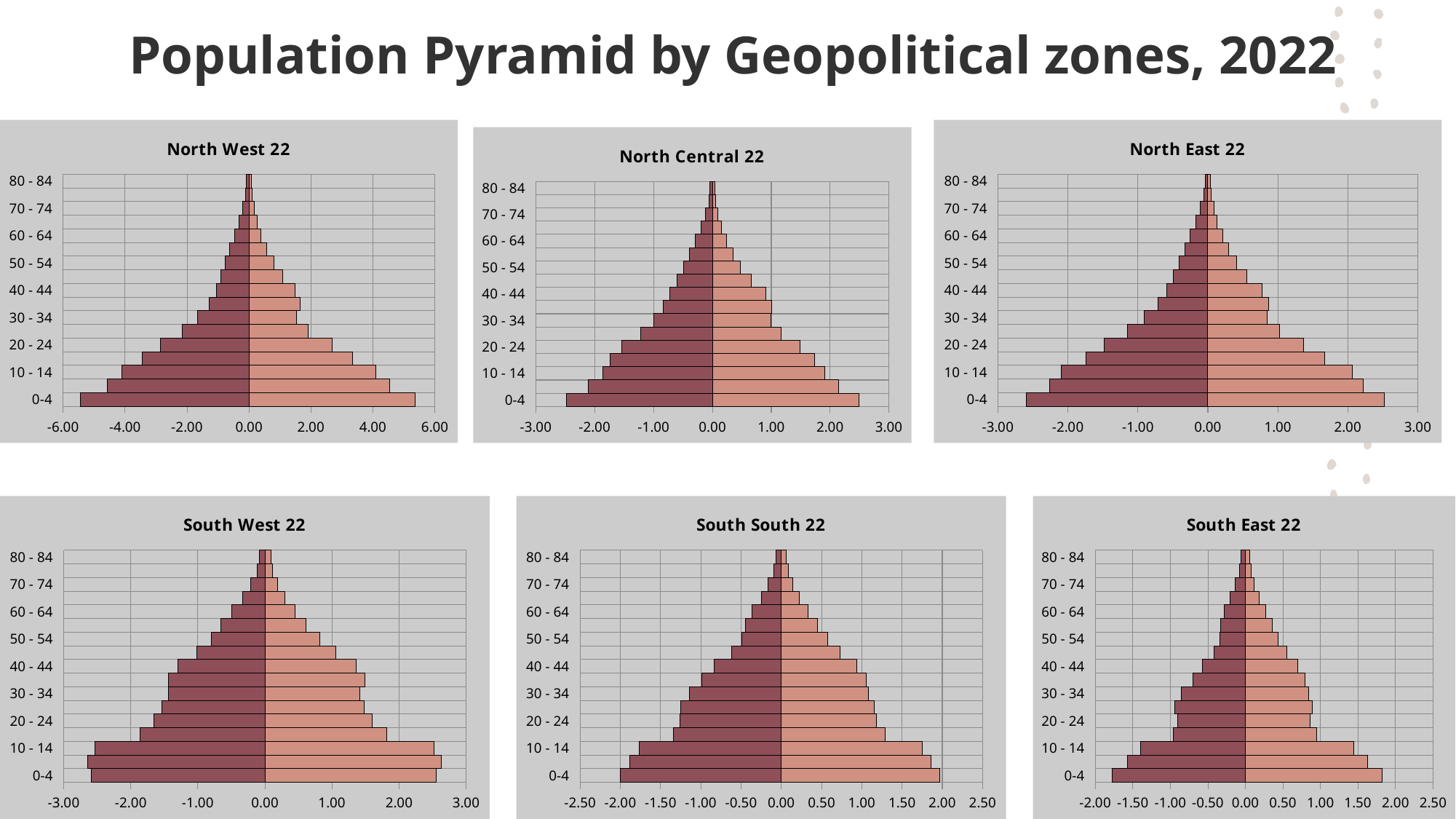
What is the title of the slide? Population Pyramid by Geopolitical zones, 2022 What kind of chart is the North West 22 chart? bar chart On the South East 22 chart, is the right-hand bar for the 0-4 age group greater or less than 1.50? greater On the North West 22 chart, is the right-hand bar for the 0-4 age group greater or less than 4.00? greater What is the largest value shown on the x axis of the North West 22 chart? 6.00 On the North West 22 chart, which age group has the longest bars? 0-4 On the North East 22 chart, is the right-hand bar for the 0-4 age group greater or less than 2.00? greater On the North East 22 chart, do the bars get longer or shorter as the age group increases from 0-4 to 80 - 84? shorter On the North Central 22 chart, which age group has the shortest bars? 80 - 84 How many charts are shown on the slide? 6